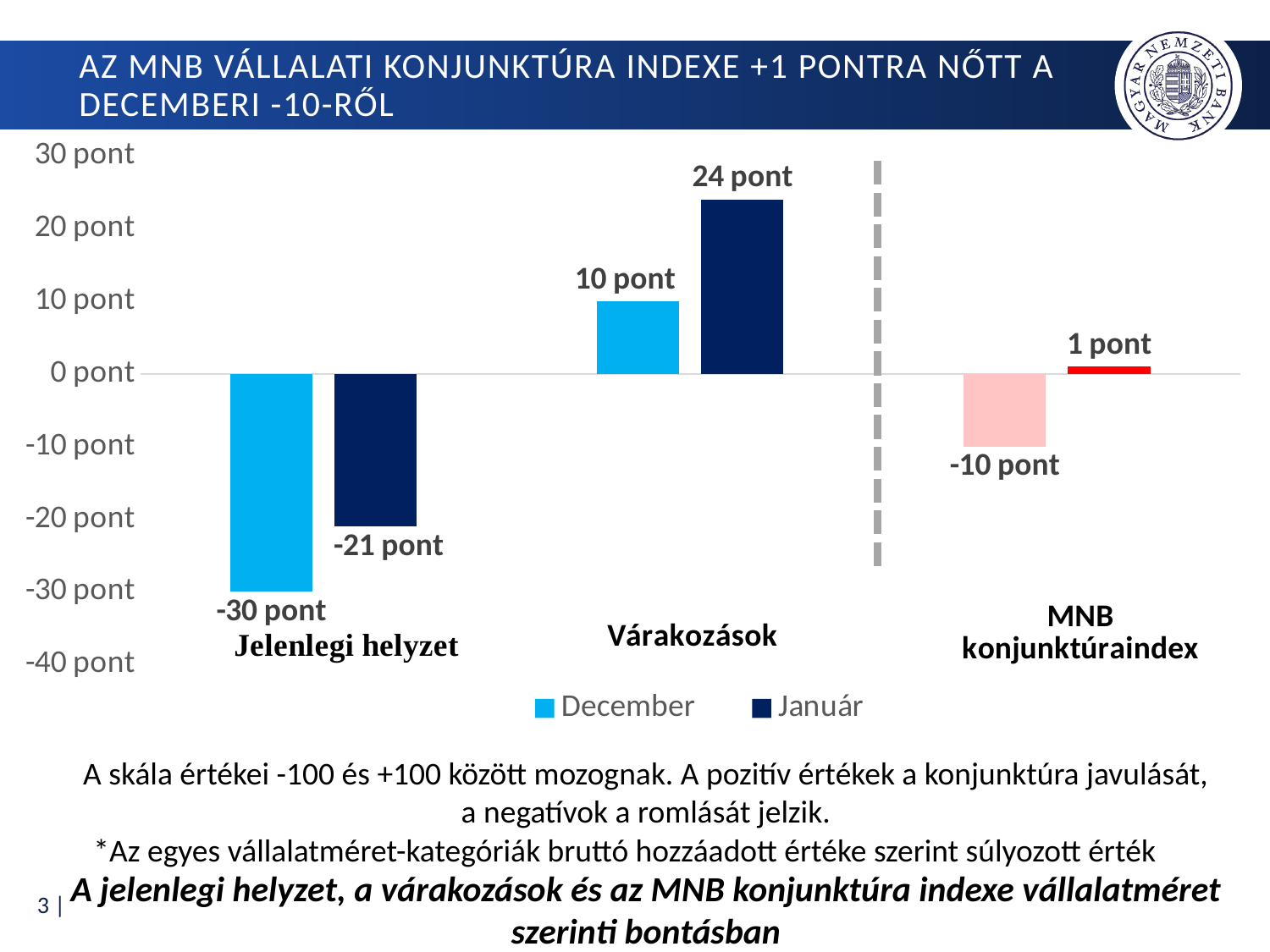
Which category has the highest Január value? Várakozások What is the Január value for Várakozások? 24 pont What is the difference between the Január and December values for Várakozások? 14 pont What is the December value for Jelenlegi helyzet? -30 pont How many series does the legend list? 2 How many categories are shown on the x axis? 3 Which is larger for MNB konjunktúraindex, the December value or the Január value? Január What kind of chart is shown on the slide? bar chart Which category has the lowest December value? Jelenlegi helyzet What is the Január value for Jelenlegi helyzet? -21 pont Which series is shown in dark blue in the legend? Január What is the December value for MNB konjunktúraindex? -10 pont